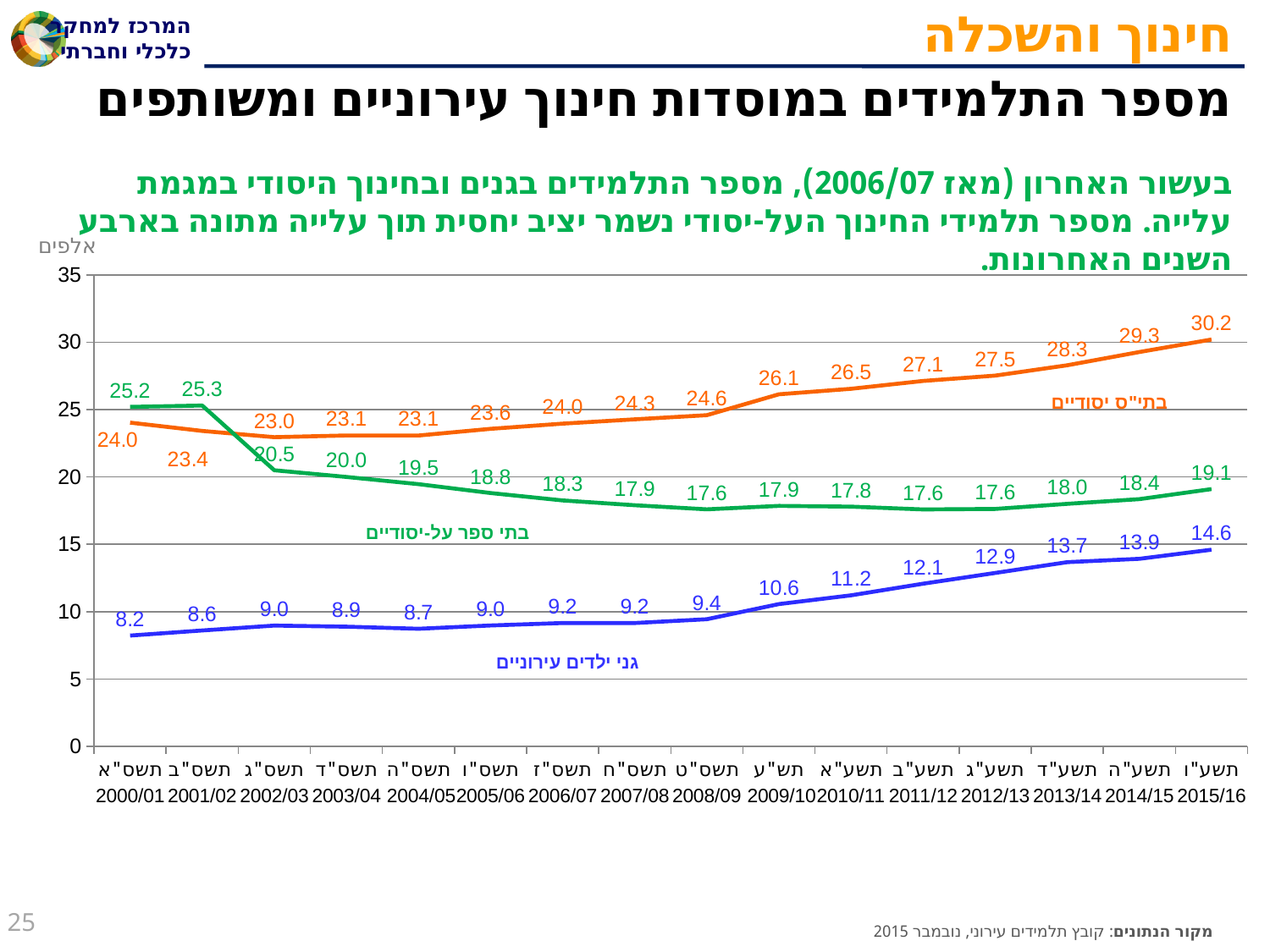
What is the value for בתי"ס יסודיים (elementary schools) in 2015/16? 30.2 What type of chart is shown on the slide? line chart How many data series are plotted in the chart? 3 How many school years are shown along the x axis? 16 What unit label is shown at the top of the y axis? אלפים What is the difference between the בתי"ס יסודיים value in 2015/16 and in 2000/01? 6.2 In which year does the בתי"ס יסודיים series reach its highest value? 2015/16 What is the lowest value shown for the גני ילדים עירוניים series? 8.2 What is the value for גני ילדים עירוניים (municipal kindergartens) in 2000/01? 8.2 In 2000/01, which series has the larger value: בתי ספר על-יסודיים or בתי"ס יסודיים? בתי ספר על-יסודיים Does the גני ילדים עירוניים series generally rise or fall from 2008/09 to 2015/16? rise What is the value for בתי ספר על-יסודיים (secondary schools) in 2008/09? 17.6